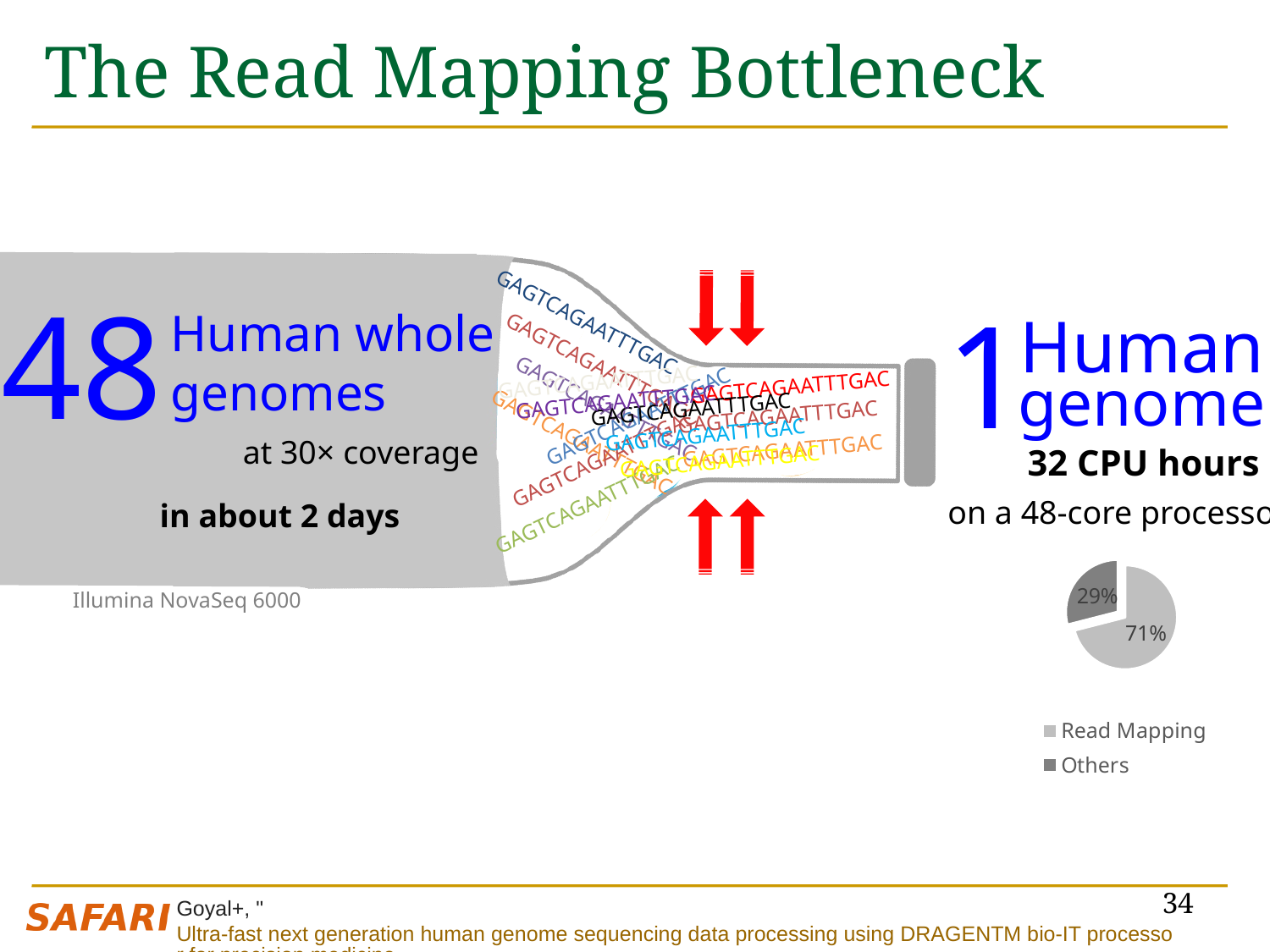
How many entries does the pie chart's legend list? 2 What are the two legend entries of the pie chart? Read Mapping, Others Which slice of the pie chart is pulled out (exploded) from the rest? Others (29%) Which is larger in the pie chart, Read Mapping or Others? Read Mapping How many slices does the pie chart have? 2 What is the difference in percentage points between the Read Mapping slice and the Others slice? 42 What kind of chart is shown on the slide? pie chart Which slice of the pie chart is the largest? Read Mapping What share of the pie chart does Read Mapping take? 71% Is the Read Mapping share of the pie chart greater or less than 50%? greater What share of the pie chart does Others take? 29% Which slice of the pie chart is the smallest? Others